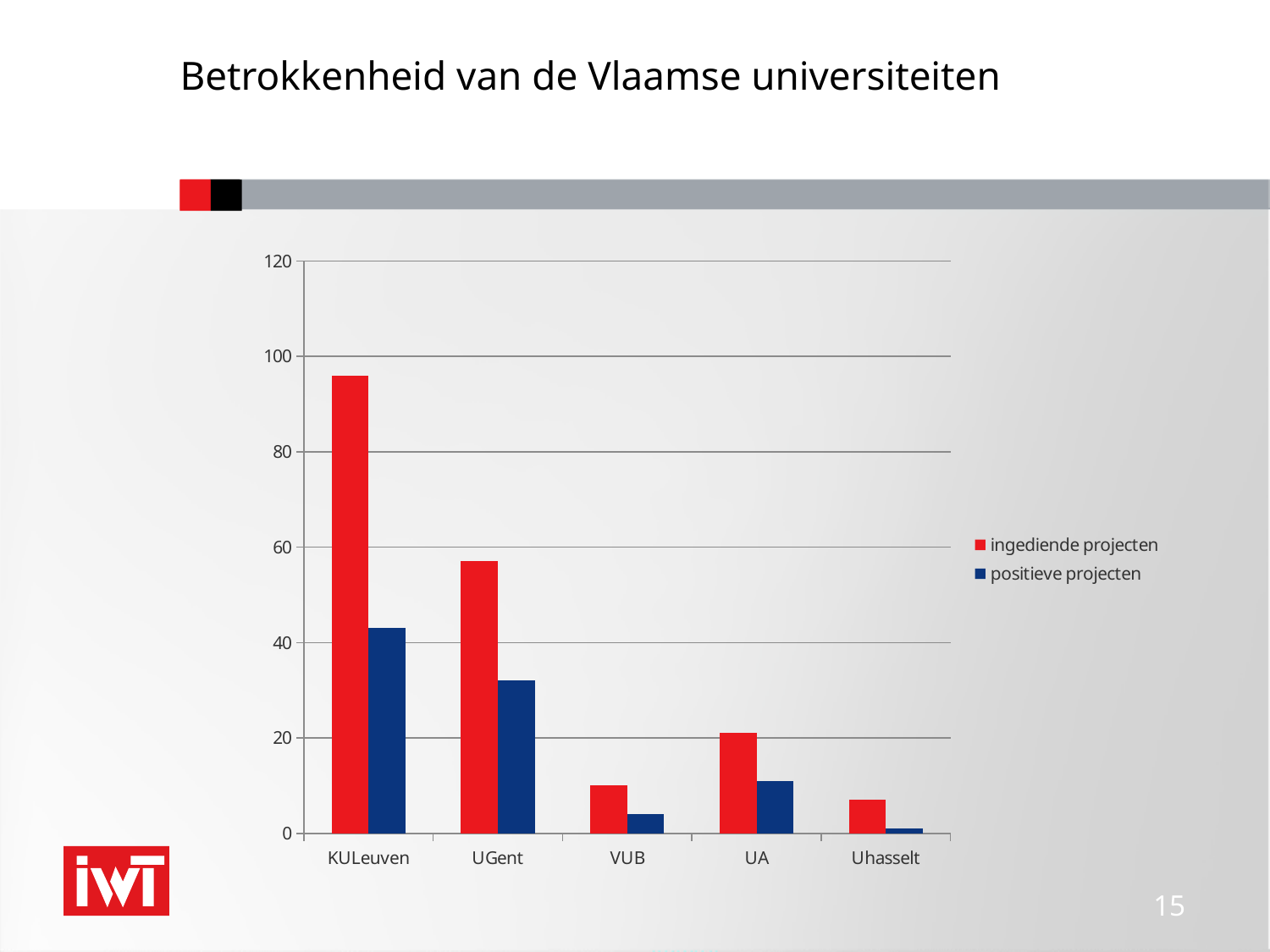
Which university has the lowest value for positieve projecten? Uhasselt What kind of chart is shown on the slide? bar chart How many universities are shown on the x axis of the chart? 5 Is the value for positieve projecten at KULeuven greater or less than 20? greater Is the value for positieve projecten at UGent greater or less than 40? less Which is larger: ingediende projecten for UGent or ingediende projecten for UA? UGent Is the value for ingediende projecten at KULeuven greater or less than 80? greater Which university has the lowest value for ingediende projecten? Uhasselt Which colour represents ingediende projecten in the chart? red Which university has the highest value for ingediende projecten? KULeuven How many series does the chart's legend list? 2